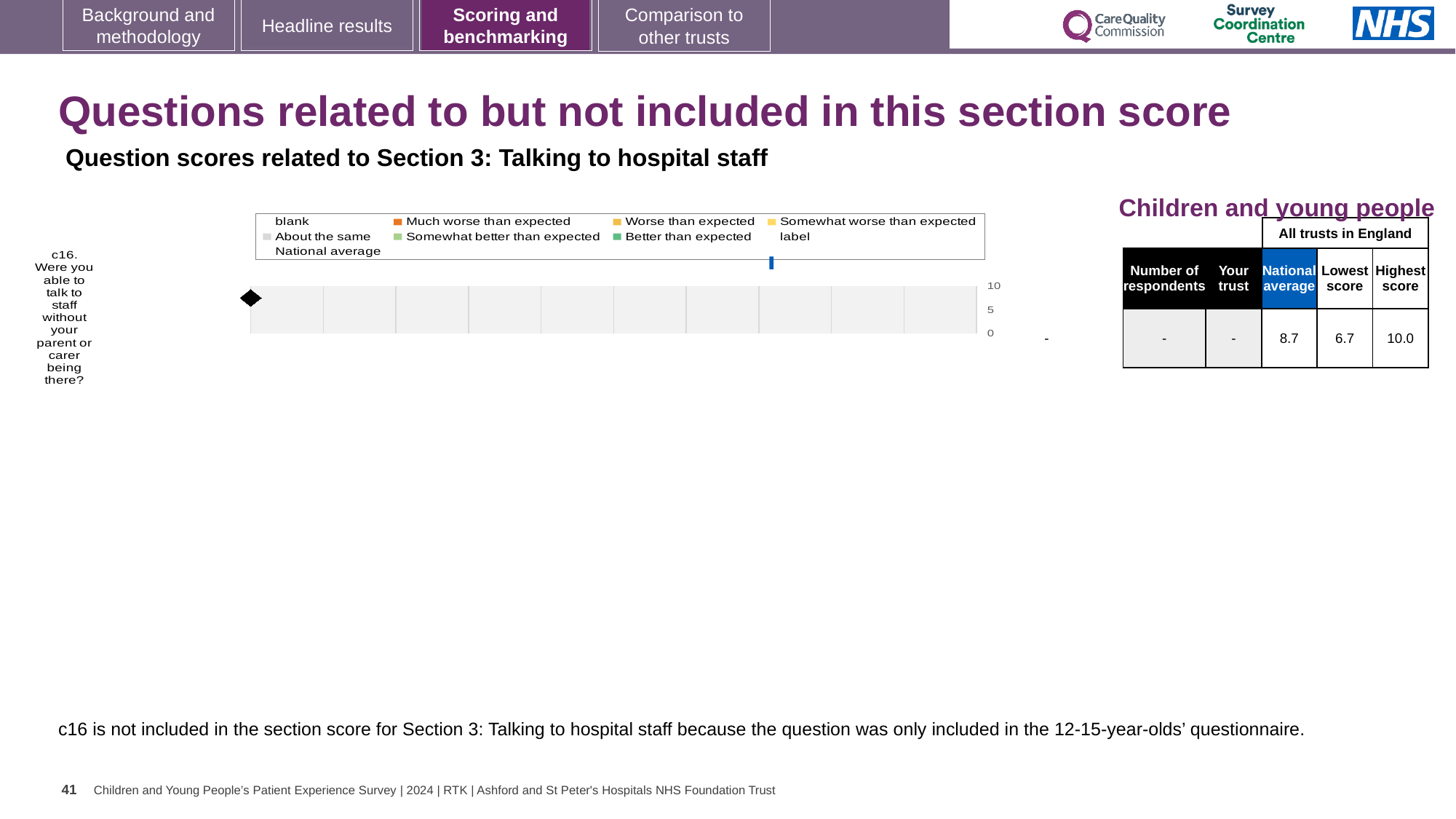
How many questions (categories) are plotted on the chart? 1 In the table next to the chart, what is the national average score for c16? 8.7 In the table next to the chart, what is the lowest score among all trusts in England for c16? 6.7 In the table next to the chart, what is the highest score among all trusts in England for c16? 10.0 Which question is shown as the category on the chart? c16. Were you able to talk to staff without your parent or carer being there? In the table next to the chart, what is the difference between the highest score and the lowest score for c16? 3.3 In the table next to the chart, what value is shown for 'Your trust' for c16? - What is the highest tick value shown on the chart's value axis? 10 What kind of chart is shown on the slide? bar chart In the table next to the chart, is the national average for c16 greater or less than the lowest score? greater